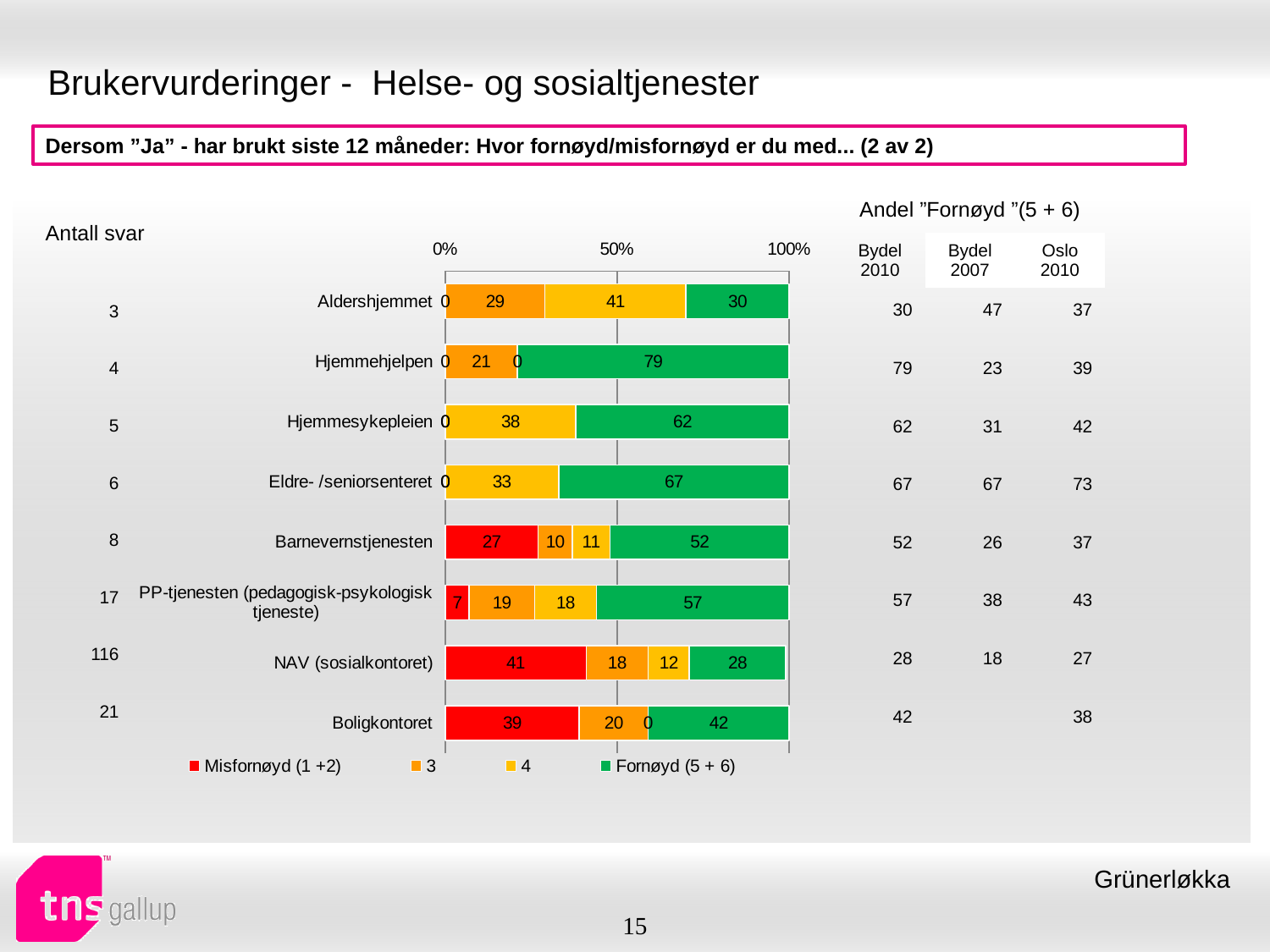
Which category has the highest Fornøyd (5 + 6) value? Hjemmehjelpen What kind of chart is shown on the slide? Stacked bar chart What is the value of the Fornøyd (5 + 6) segment for Hjemmehjelpen? 79 What is the difference between the Fornøyd (5 + 6) values for Hjemmehjelpen and Aldershjemmet? 49 What is the value of the Misfornøyd (1 +2) segment for PP-tjenesten (pedagogisk-psykologisk tjeneste)? 7 What is the value of the '4' segment for Aldershjemmet? 41 What is the value of the Misfornøyd (1 +2) segment for NAV (sosialkontoret)? 41 How many categories are shown in the chart? 8 What colour represents Fornøyd (5 + 6) in the chart? Green How many series does the legend list? 4 Which has the larger Misfornøyd (1 +2) value, NAV (sosialkontoret) or Boligkontoret? NAV (sosialkontoret) Which category has the lowest Fornøyd (5 + 6) value? NAV (sosialkontoret)